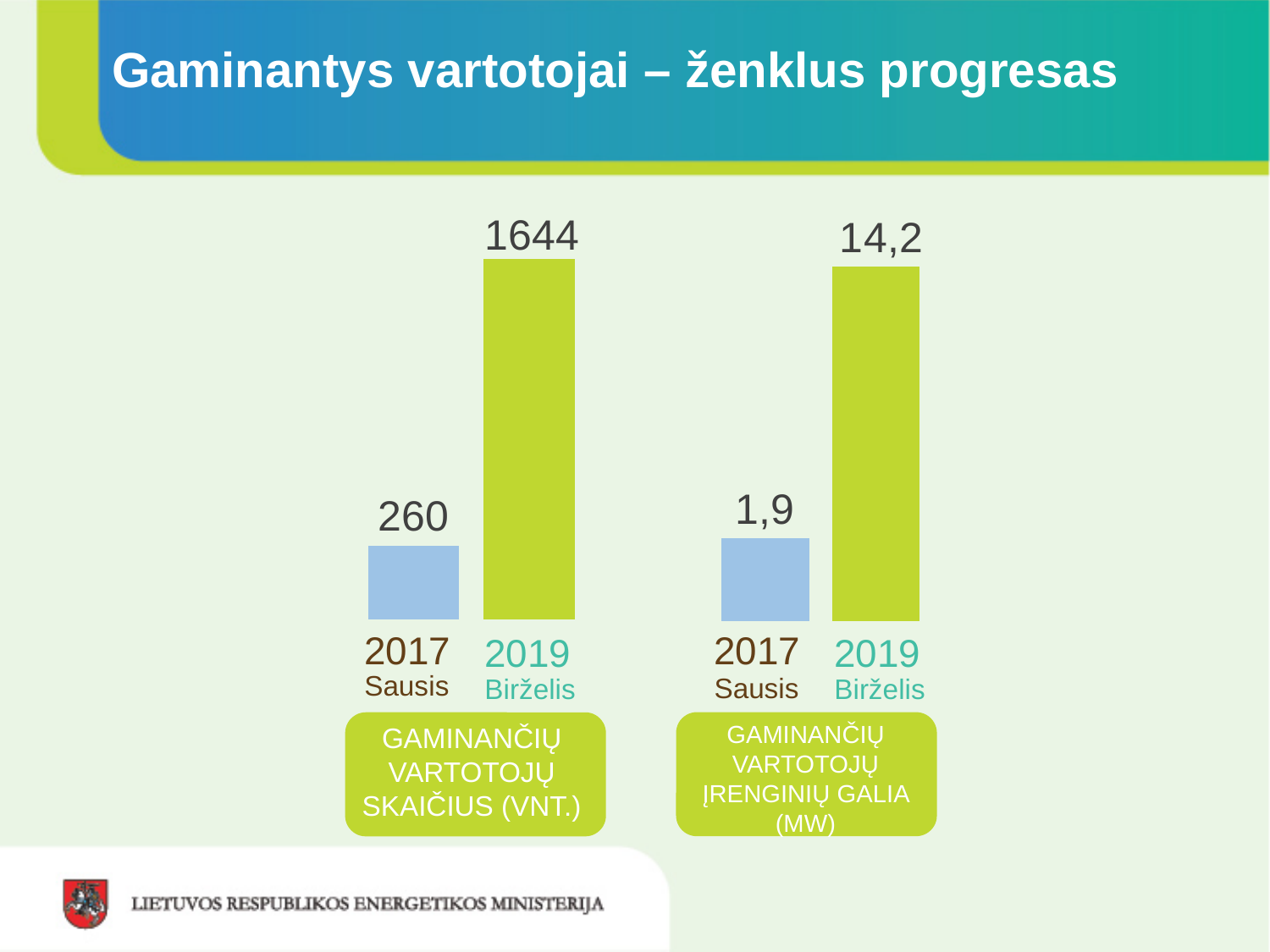
In the left chart (GAMINANČIŲ VARTOTOJŲ SKAIČIUS (VNT.)), what is the value for 2017 Sausis? 260 In the left chart (GAMINANČIŲ VARTOTOJŲ SKAIČIUS (VNT.)), what is the difference between the 2019 Birželis and 2017 Sausis values? 1384 In the left chart (GAMINANČIŲ VARTOTOJŲ SKAIČIUS (VNT.)), do the values rise or fall from 2017 Sausis to 2019 Birželis? Rise In the right chart (GAMINANČIŲ VARTOTOJŲ ĮRENGINIŲ GALIA (MW)), what is the value for 2019 Birželis? 14,2 What kind of chart is the right chart (GAMINANČIŲ VARTOTOJŲ ĮRENGINIŲ GALIA (MW))? Bar chart How many bars does the left chart (GAMINANČIŲ VARTOTOJŲ SKAIČIUS (VNT.)) have? 2 In the right chart (GAMINANČIŲ VARTOTOJŲ ĮRENGINIŲ GALIA (MW)), what is the difference between the 2019 Birželis and 2017 Sausis values? 12,3 In the right chart (GAMINANČIŲ VARTOTOJŲ ĮRENGINIŲ GALIA (MW)), which period has the lowest value? 2017 Sausis In the left chart (GAMINANČIŲ VARTOTOJŲ SKAIČIUS (VNT.)), which period has the highest value? 2019 Birželis In the left chart (GAMINANČIŲ VARTOTOJŲ SKAIČIUS (VNT.)), what is the value for 2019 Birželis? 1644 In the right chart (GAMINANČIŲ VARTOTOJŲ ĮRENGINIŲ GALIA (MW)), which is larger: the value for 2017 Sausis or 2019 Birželis? 2019 Birželis In the right chart (GAMINANČIŲ VARTOTOJŲ ĮRENGINIŲ GALIA (MW)), what is the value for 2017 Sausis? 1,9